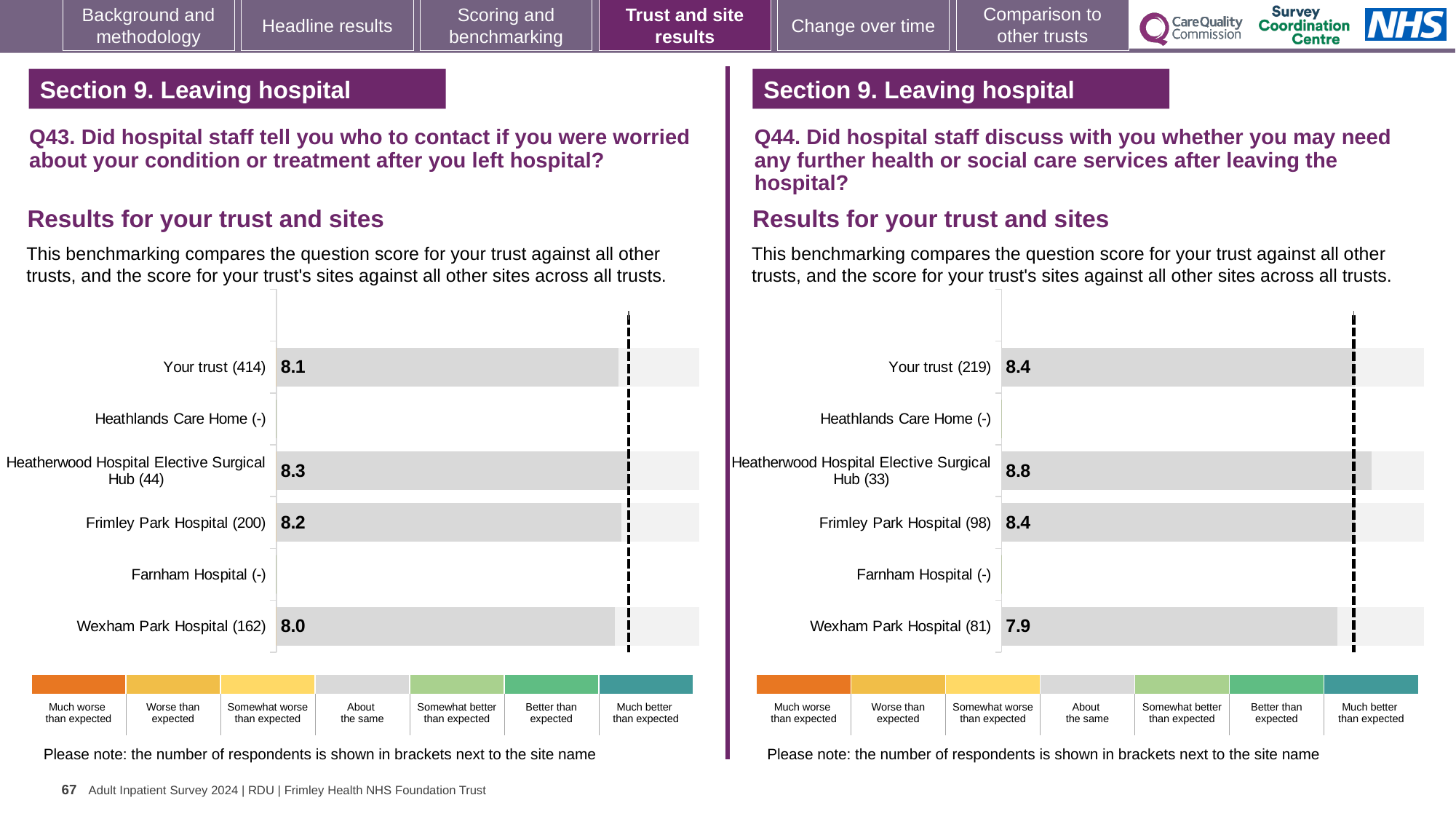
How many categories are listed on the vertical axis of the Q43 chart on the left? 6 In the Q43 chart on the left, what is the score for Frimley Park Hospital? 8.2 In the Q43 chart on the left, what is the score for Your trust? 8.1 In the Q44 chart on the right, which is larger: the score for Heatherwood Hospital Elective Surgical Hub or the score for Frimley Park Hospital? Heatherwood Hospital Elective Surgical Hub In the Q44 chart on the right, what is the difference between the scores for Your trust and Wexham Park Hospital? 0.5 In the Q44 chart on the right, what is the score for Wexham Park Hospital? 7.9 What kind of chart is used for the Q44 results on the right? Bar chart In the Q44 chart on the right, what is the score for Heatherwood Hospital Elective Surgical Hub? 8.8 In the Q43 chart on the left, what is the difference between the scores for Heatherwood Hospital Elective Surgical Hub and Wexham Park Hospital? 0.3 In the Q43 chart on the left, which site has the lowest score? Wexham Park Hospital In the Q44 chart on the right, which site has the lowest score? Wexham Park Hospital In the Q43 chart on the left, which site has the highest score? Heatherwood Hospital Elective Surgical Hub